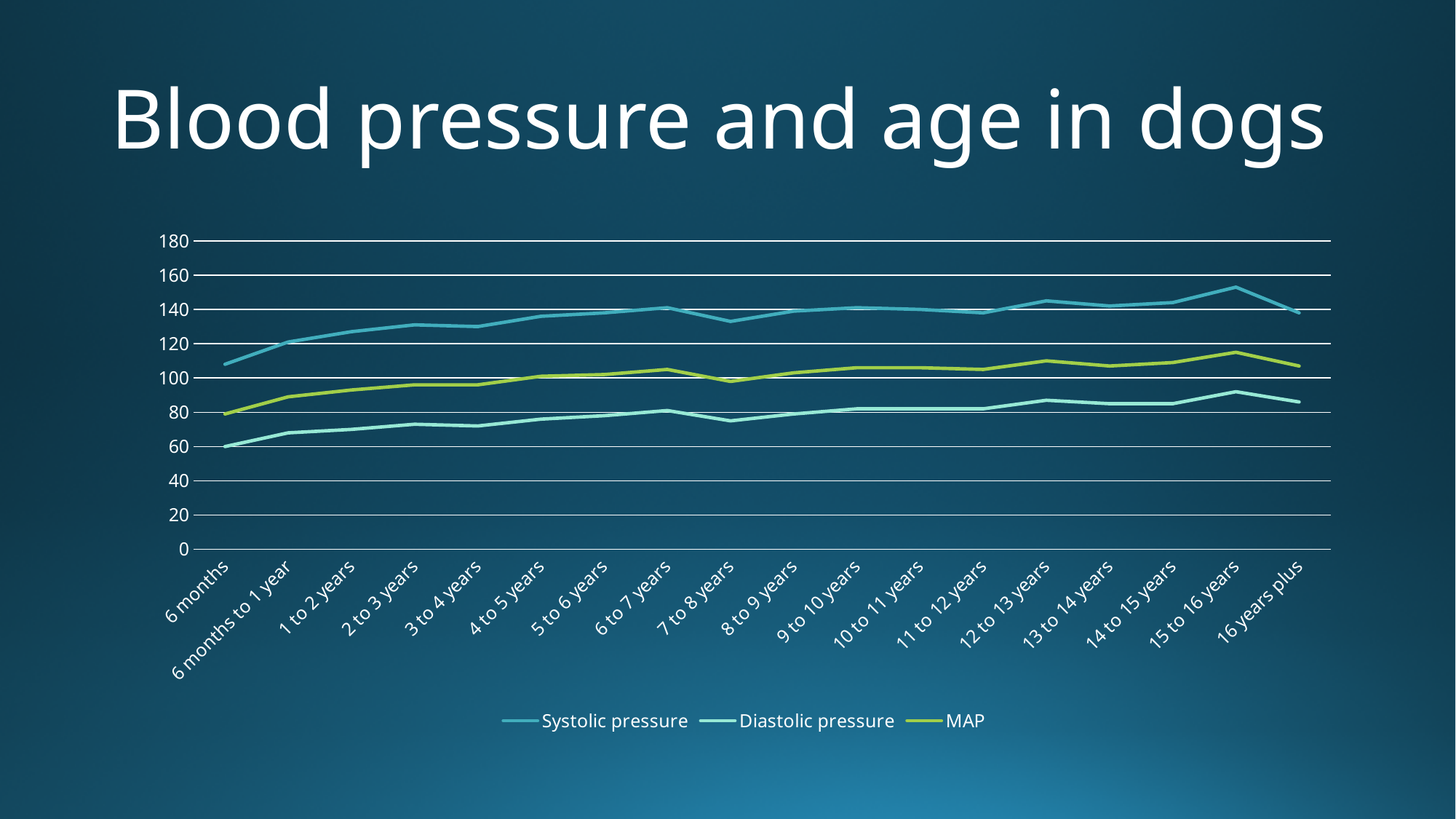
At which age category is Systolic pressure lowest? 6 months At which age category is MAP highest? 15 to 16 years How many series does the legend list? 3 At which age category is Diastolic pressure lowest? 6 months At which age category is Systolic pressure highest? 15 to 16 years Which series is drawn in green? MAP Is the MAP value for 15 to 16 years greater or less than 100? greater What is the title of the slide's chart? Blood pressure and age in dogs What kind of chart is shown on the slide? Line chart How many age categories are plotted along the x axis? 18 Which is larger at 6 to 7 years, Systolic pressure or Diastolic pressure? Systolic pressure Is the Systolic pressure value for 7 to 8 years greater or less than 120? greater